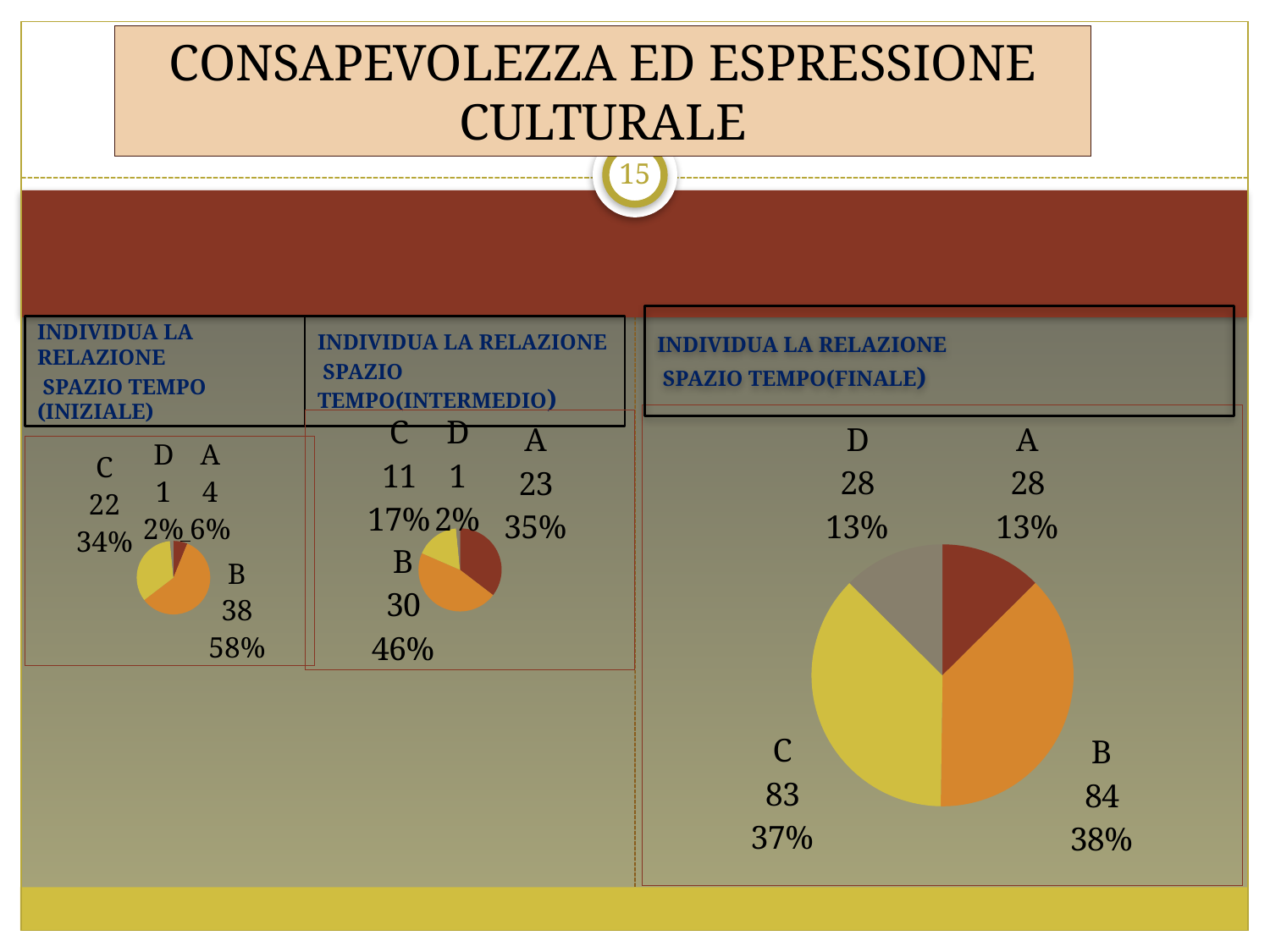
In the INDIVIDUA LA RELAZIONE SPAZIO TEMPO (FINALE) chart, what is the value for C? 83 In the INDIVIDUA LA RELAZIONE SPAZIO TEMPO (INIZIALE) chart, what share of the pie does C represent? 34% In the INDIVIDUA LA RELAZIONE SPAZIO TEMPO (INTERMEDIO) chart, what is the value for A? 23 In the INDIVIDUA LA RELAZIONE SPAZIO TEMPO (FINALE) chart, what share of the pie does D represent? 13% In the INDIVIDUA LA RELAZIONE SPAZIO TEMPO (INTERMEDIO) chart, which category has the highest value? B In the INDIVIDUA LA RELAZIONE SPAZIO TEMPO (INTERMEDIO) chart, what is the difference between the values for B and C? 19 In the INDIVIDUA LA RELAZIONE SPAZIO TEMPO (INTERMEDIO) chart, what share of the pie does A represent? 35% In the INDIVIDUA LA RELAZIONE SPAZIO TEMPO (INIZIALE) chart, which category has the lowest value? D How many categories does the INDIVIDUA LA RELAZIONE SPAZIO TEMPO (FINALE) chart show? 4 In the INDIVIDUA LA RELAZIONE SPAZIO TEMPO (FINALE) chart, is the value for A larger or smaller than the value for B? smaller What kind of chart is the INDIVIDUA LA RELAZIONE SPAZIO TEMPO (FINALE) chart? pie chart In the INDIVIDUA LA RELAZIONE SPAZIO TEMPO (INIZIALE) chart, what is the value for B? 38